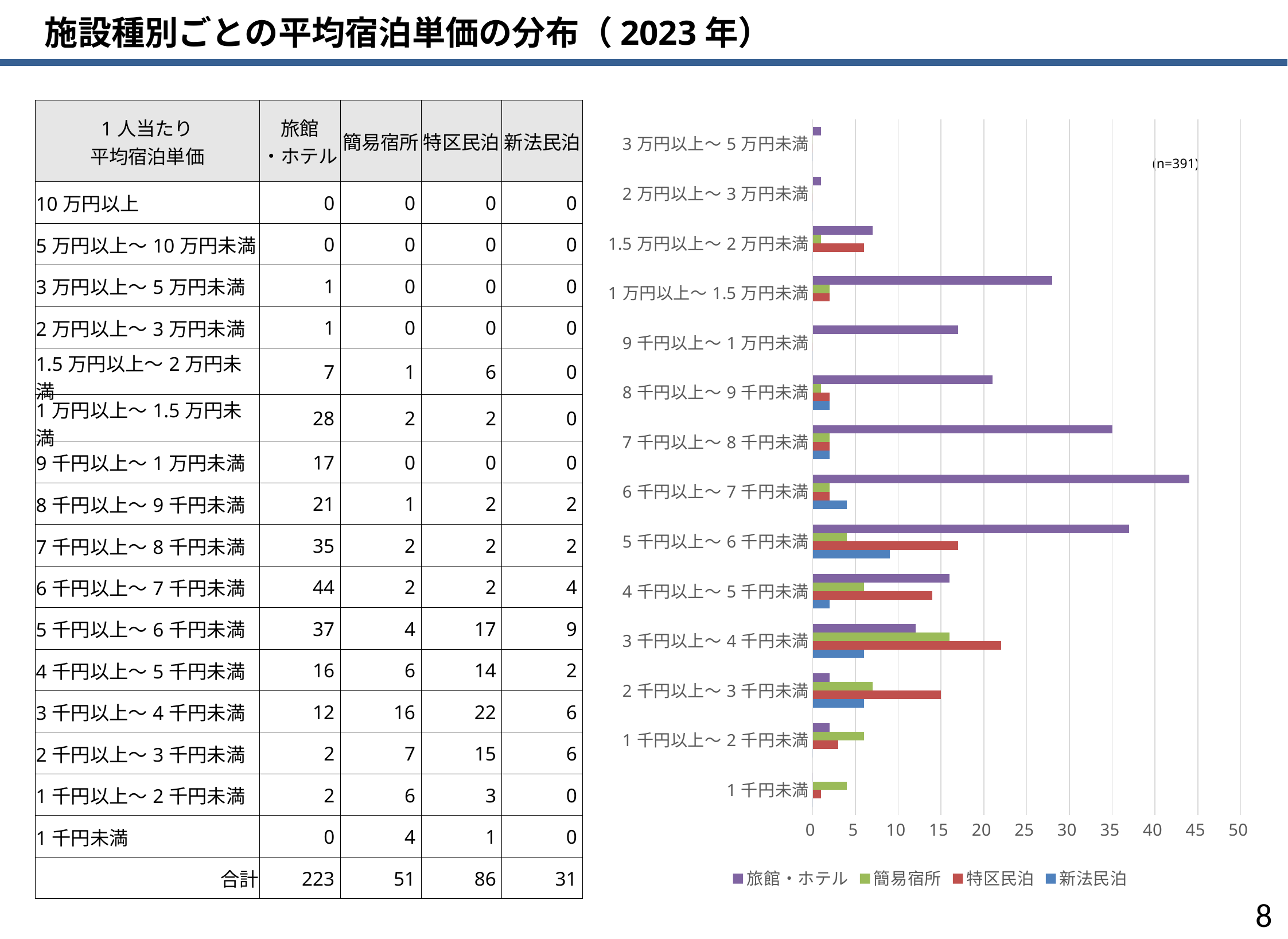
How many series does the chart legend list? 4 What sample size (n) is noted on the chart? n=391 What is the difference between the 旅館・ホテル values for 6千円以上～7千円未満 and 5千円以上～6千円未満? 7 Is the 旅館・ホテル value for 6千円以上～7千円未満 greater or less than 40? greater What kind of chart is shown on the right side of the slide? bar chart How many price-range categories are plotted on the chart's vertical axis? 14 Which price range has the highest value for 旅館・ホテル? 6千円以上～7千円未満 What is the value for 特区民泊 in the 5千円以上～6千円未満 range? 17 What is the value for 新法民泊 in the 5千円以上～6千円未満 range? 9 In the 3千円以上～4千円未満 range, which is larger: 特区民泊 or 簡易宿所? 特区民泊 Which price range has the highest value for 簡易宿所? 3千円以上～4千円未満 Is the 特区民泊 value for 3千円以上～4千円未満 greater or less than 20? greater